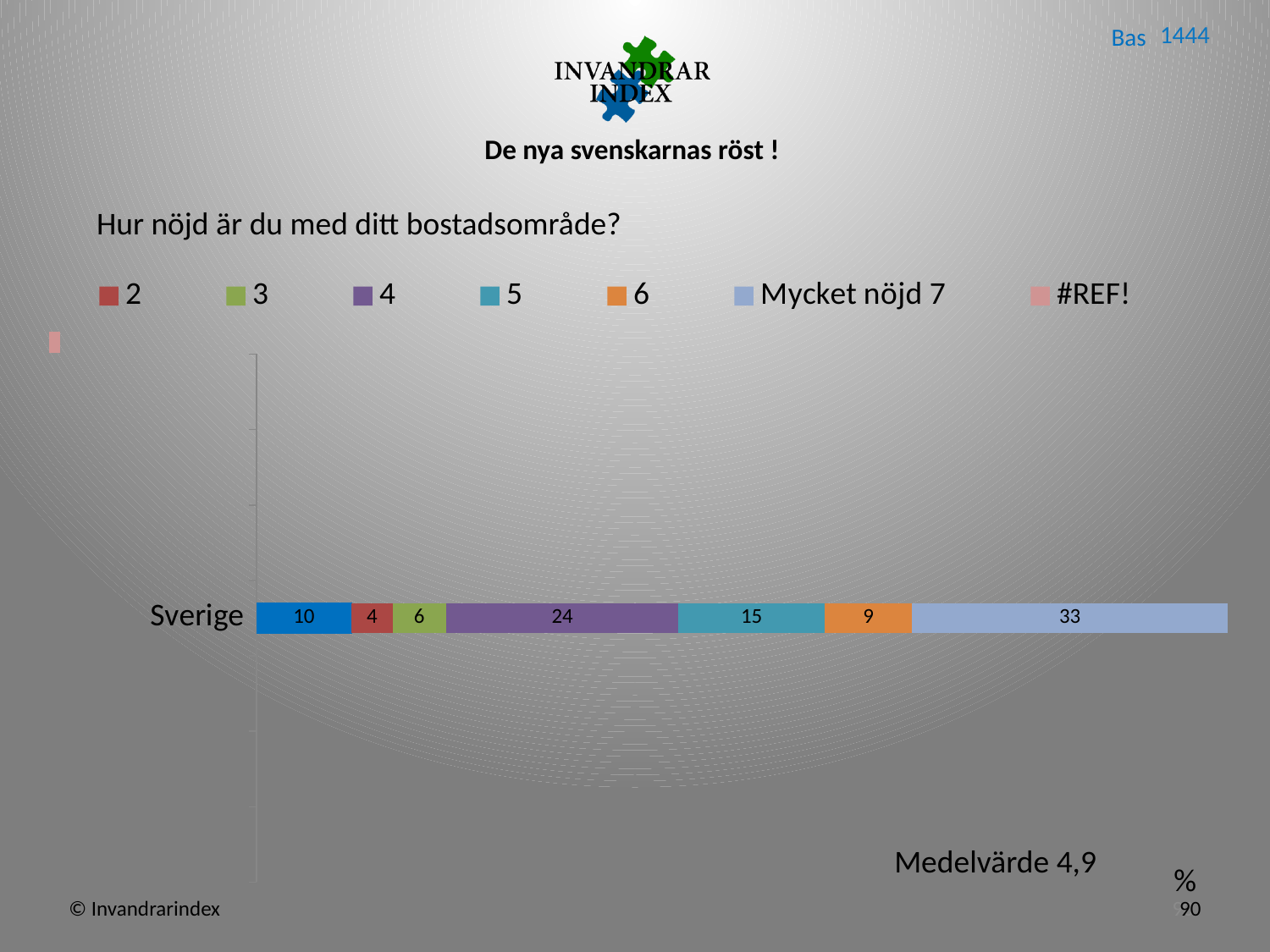
Which legend series has the smallest segment in the Sverige bar? 2 What is the difference between the "Mycket nöjd 7" segment and the "4" segment for Sverige? 9 What is the value of the "Mycket nöjd 7" segment for Sverige? 33 What is the value of the "2" segment for Sverige? 4 What is the value of the "5" segment for Sverige? 15 Which is larger for Sverige, the "5" segment or the "6" segment? 5 What is the value of the "4" segment for Sverige? 24 How many categories (bars) are plotted in the chart? 1 What is the total of all the labelled segments in the Sverige bar? 101 What is the Medelvärde (mean value) shown on the slide? 4,9 Which legend series has the largest segment in the Sverige bar? Mycket nöjd 7 What kind of chart is shown on the slide? Stacked bar chart